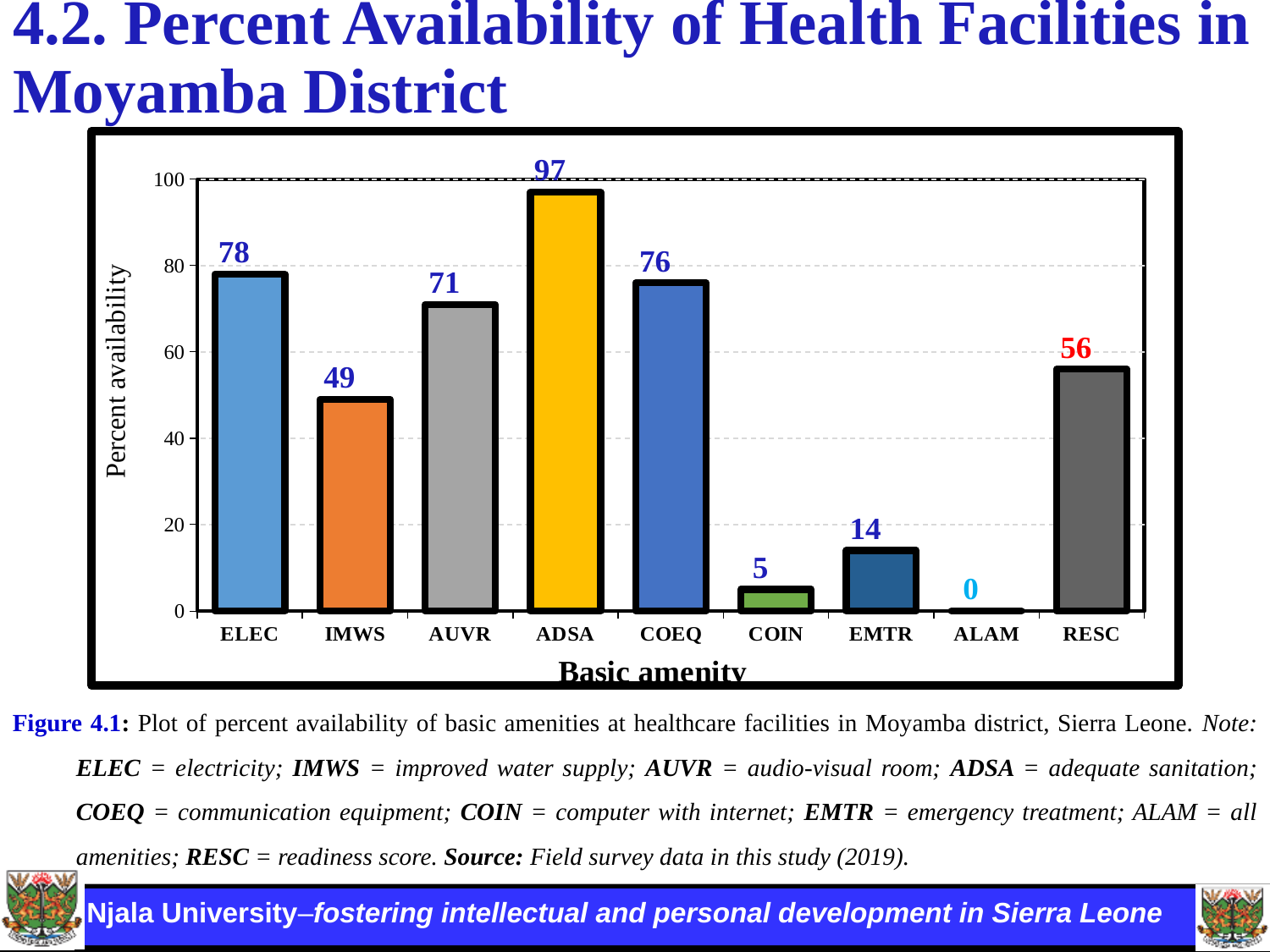
What is the percent availability for RESC? 56 What is the label of the x axis? Basic amenity How many basic amenities are shown on the x axis? 9 What kind of chart is shown on the slide? Bar chart What is the label of the y axis? Percent availability What is the percent availability for ELEC? 78 What is the difference in percent availability between ADSA and COEQ? 21 Which basic amenity has the lowest percent availability? ALAM Which basic amenity has the highest percent availability? ADSA What is the percent availability for COIN? 5 Is the value for IMWS greater or less than 60? less Which has a higher percent availability, ELEC or AUVR? ELEC